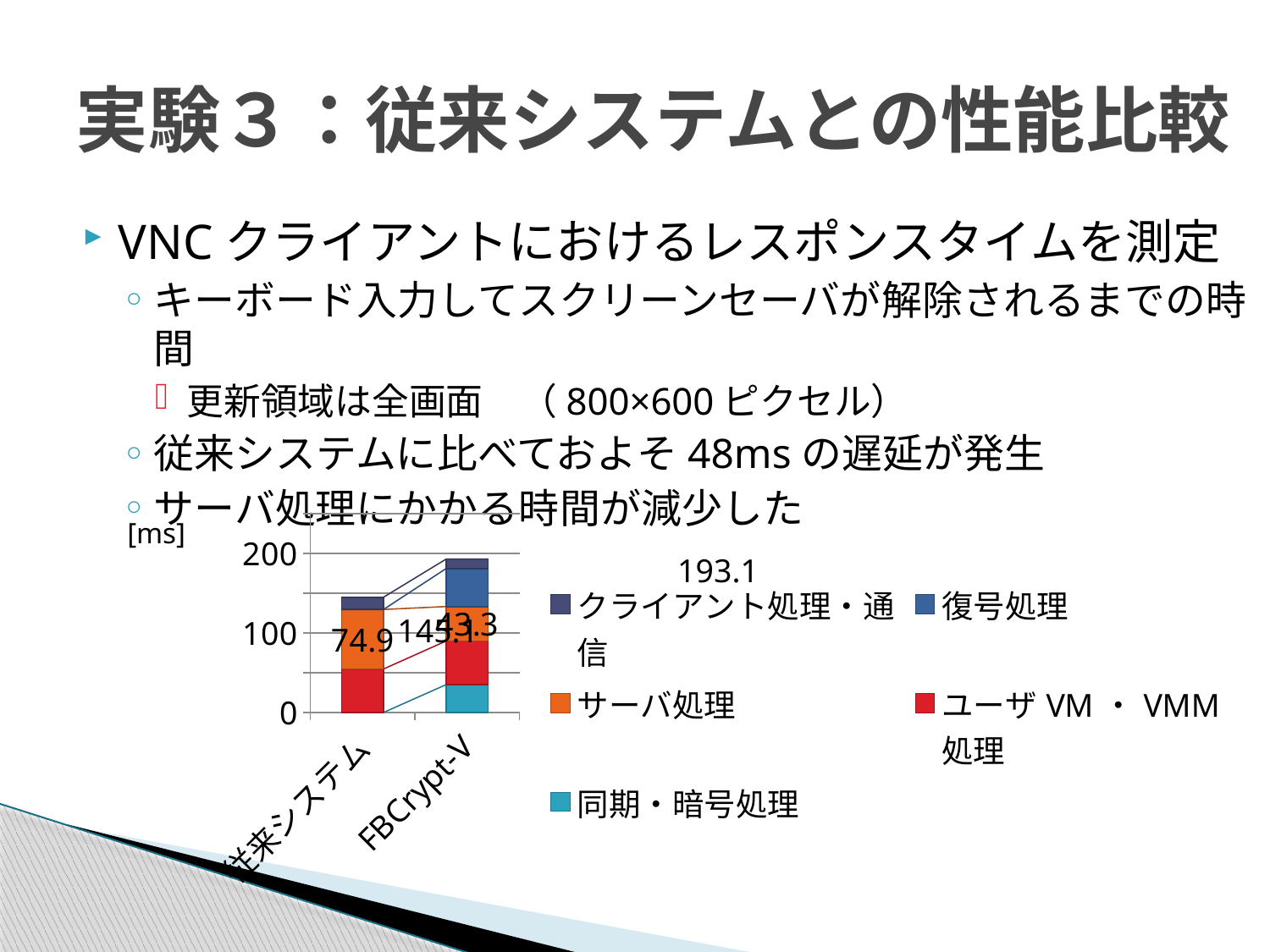
What kind of chart is shown on the slide? stacked bar chart Is the total bar height for 従来システム greater or less than 100? greater Do the total bar heights rise or fall from 従来システム to FBCrypt-V? rise Which category has the highest total bar height? FBCrypt-V Which category has the lowest total bar height? 従来システム Is the total bar height for FBCrypt-V greater or less than 200? less What unit is shown on the y axis of the chart? [ms] How many series does the chart legend list? 5 Which category has the taller stacked bar, 従来システム or FBCrypt-V? FBCrypt-V Which legend entry is shown in orange? サーバ処理 Is the total bar height for 従来システム greater or less than 200? less How many categories are shown on the x axis of the chart? 2